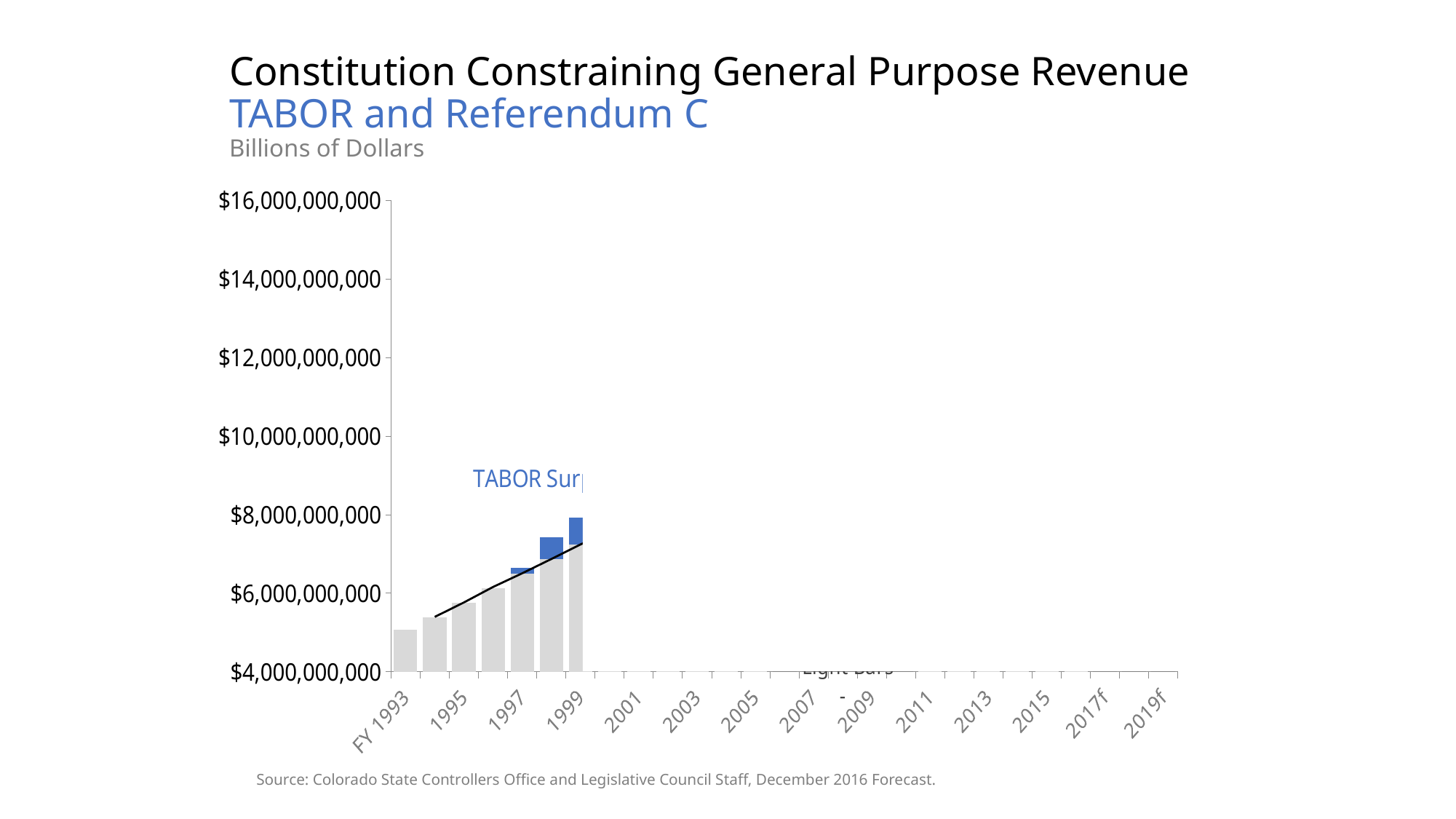
Which year has the tallest bar on the chart? 1999 Is the total bar for 1999 greater or less than $6,000,000,000? greater Do the bar values rise or fall from FY 1993 to 1999? rise Is the bar for 1995 greater or less than $6,000,000,000? less What is the highest value labelled on the y axis? $16,000,000,000 Is the bar for FY 1993 greater or less than $6,000,000,000? less Which bar is taller, 1999 or 1995? 1999 How many bars are plotted on the chart? 7 How many bars have a blue TABOR surplus segment on top? 3 What kind of chart is shown on the slide? combination bar and line chart Which year has the shortest bar on the chart? FY 1993 What unit is stated below the chart title? Billions of Dollars